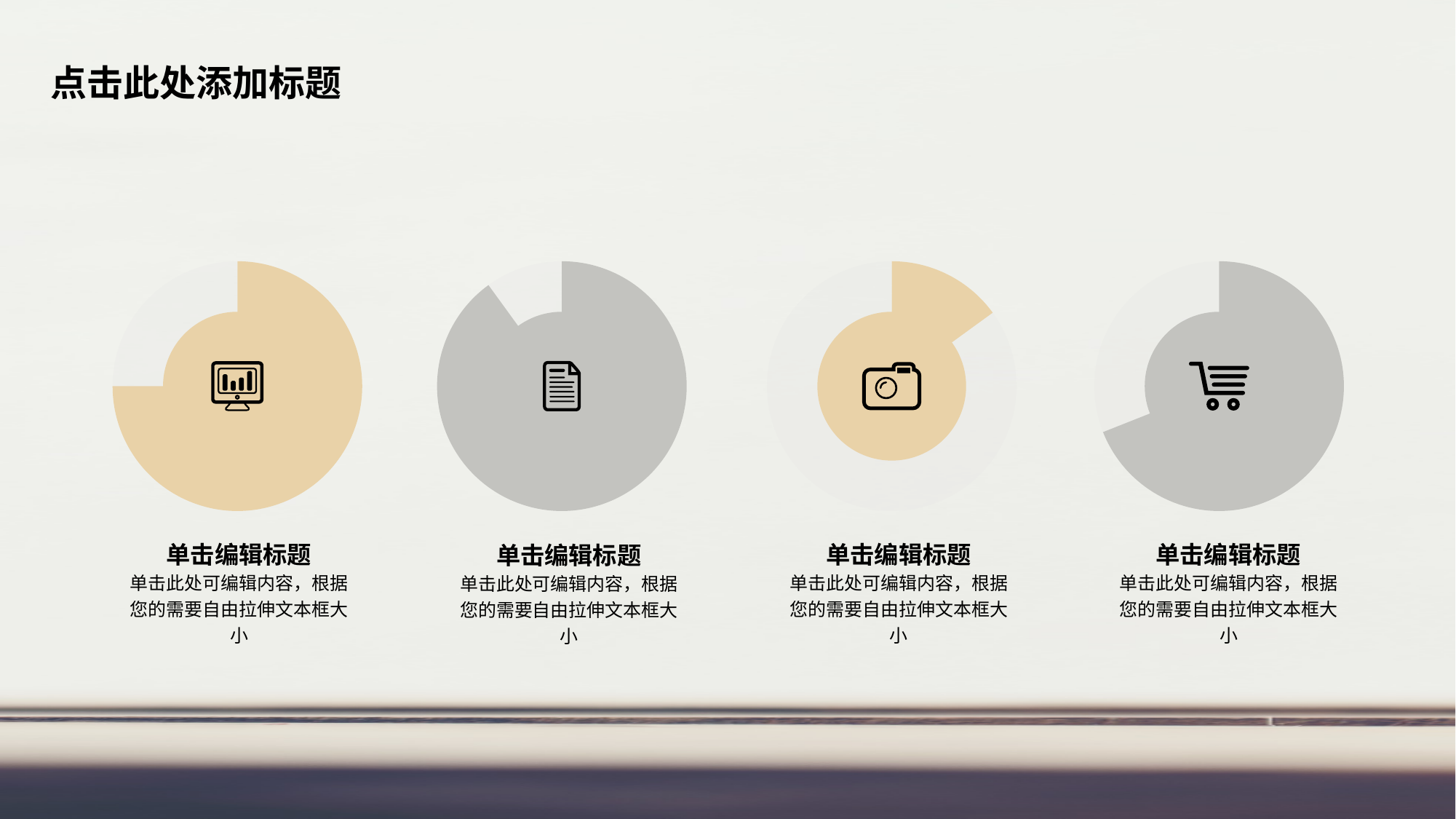
Is the filled slice of the second pie chart from the left larger or smaller than the filled slice of the rightmost pie chart? larger What colour is the filled slice of the rightmost pie chart? grey What kind of chart is shown in the leftmost position on the slide? pie chart Which of the four pie charts has the largest filled slice? the second from the left How many pie charts are on the slide? 4 What colour is the filled slice of the leftmost pie chart? tan (beige) Which of the four pie charts has the smallest filled slice? the third from the left Is the filled slice of the leftmost pie chart larger or smaller than the filled slice of the third pie chart from the left? larger